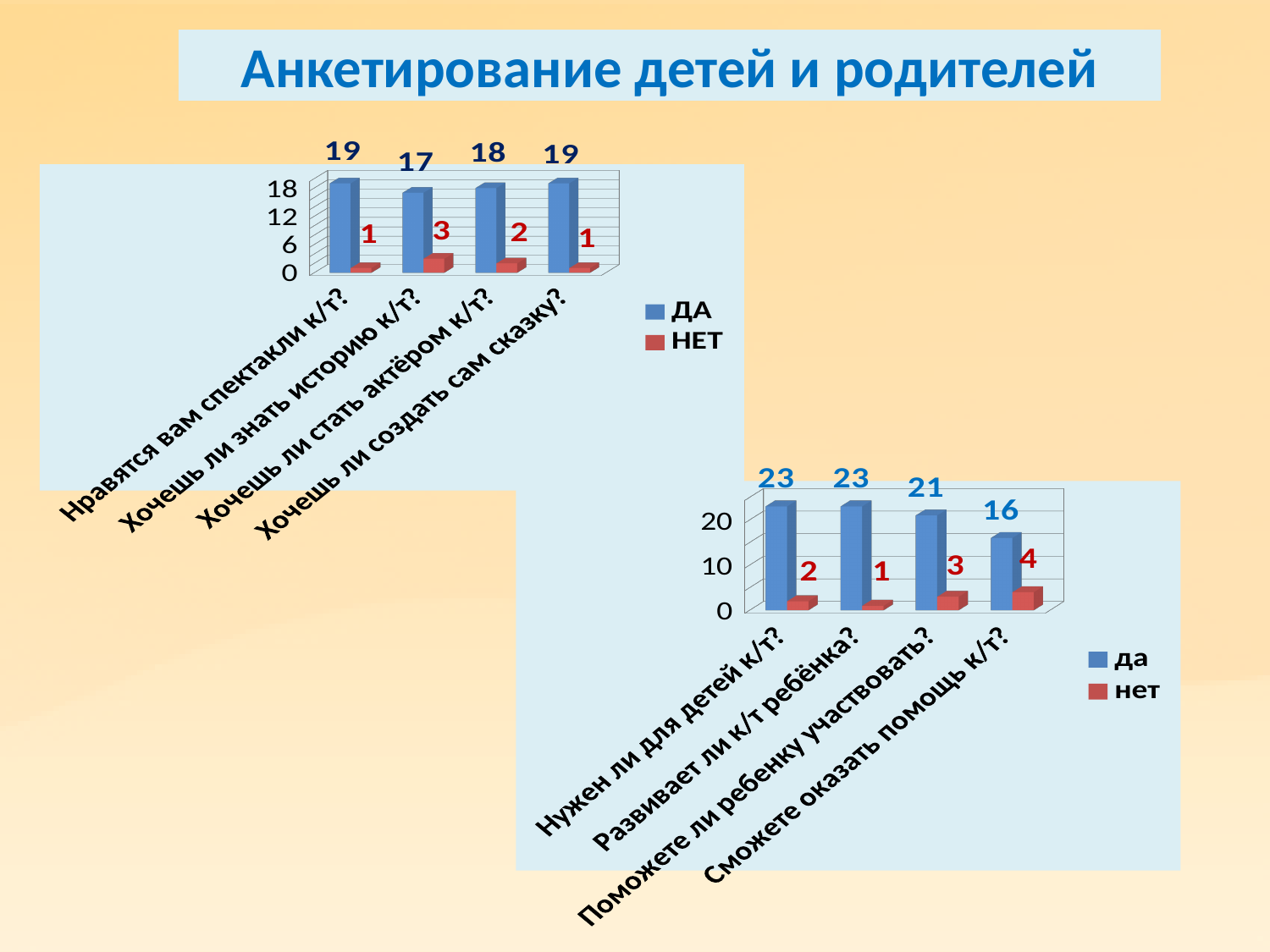
In the top-left chart, what is the value of НЕТ for "Хочешь ли стать актёром к/т?"? 2 In the bottom-right chart, how many categories are shown on the x axis? 4 In the top-left chart, what is the value of ДА for "Хочешь ли знать историю к/т?"? 17 In the top-left chart, what kind of chart is shown? Bar chart In the top-left chart, what is the difference between ДА and НЕТ for "Нравятся вам спектакли к/т?"? 18 In the top-left chart, how many series does the legend list? 2 In the bottom-right chart, what is the value of нет for "Поможете ли ребенку участвовать?"? 3 In the bottom-right chart, what is the total of да and нет for "Сможете оказать помощь к/т?"? 20 In the bottom-right chart, which is larger: нет for "Нужен ли для детей к/т?" or нет for "Развивает ли к/т ребёнка?"? Нужен ли для детей к/т? In the top-left chart, which category has the highest НЕТ value? Хочешь ли знать историю к/т? In the bottom-right chart, what is the value of да for "Сможете оказать помощь к/т?"? 16 In the bottom-right chart, which category has the lowest да value? Сможете оказать помощь к/т?